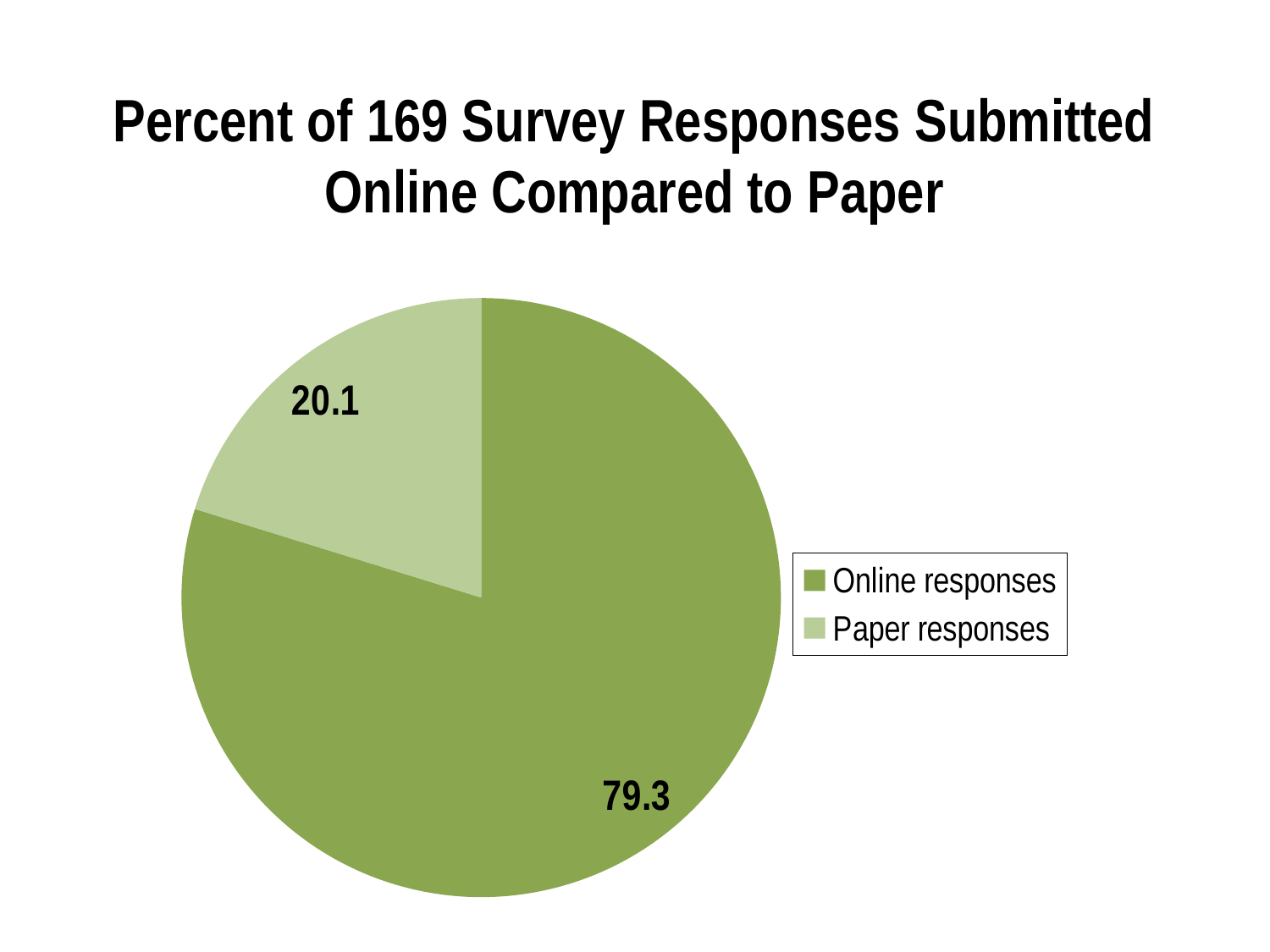
Which is larger, Online responses or Paper responses? Online responses What is the title of the chart? Percent of 169 Survey Responses Submitted Online Compared to Paper How many entries does the legend list? 2 How many slices does the pie chart have? 2 Which slice is the largest? Online responses What is the difference between the Online responses value and the Paper responses value? 59.2 What is the value shown for Online responses? 79.3 Which legend entry is shown in the lighter green colour? Paper responses What is the value shown for Paper responses? 20.1 Which slice is the smallest? Paper responses What kind of chart is shown on the slide? Pie chart